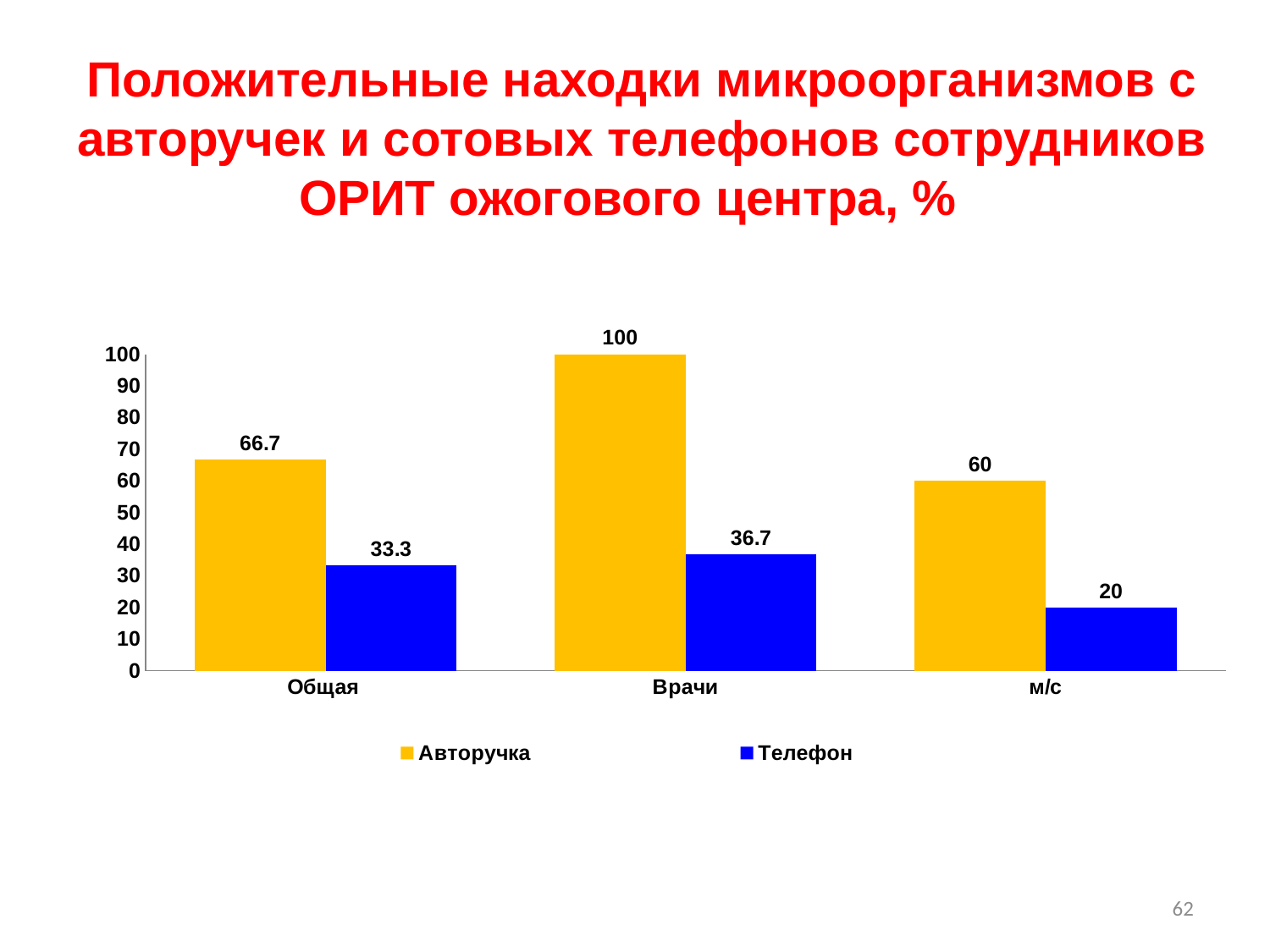
Which colour represents the Телефон series? Blue What is the difference between the Авторучка and Телефон values in the Врачи category? 63.3 What is the difference between the Авторучка values for Общая and м/с? 6.7 What is the value for Телефон in the м/с category? 20 How many categories are shown on the x axis? 3 What is the value for Авторучка in the Общая category? 66.7 Which is larger: the Телефон value for Общая or the Телефон value for Врачи? Врачи How many series does the legend list? 2 Which category has the highest value for Авторучка? Врачи What kind of chart is shown on the slide? Bar chart Which category has the lowest value for Телефон? м/с What is the value for Телефон in the Врачи category? 36.7